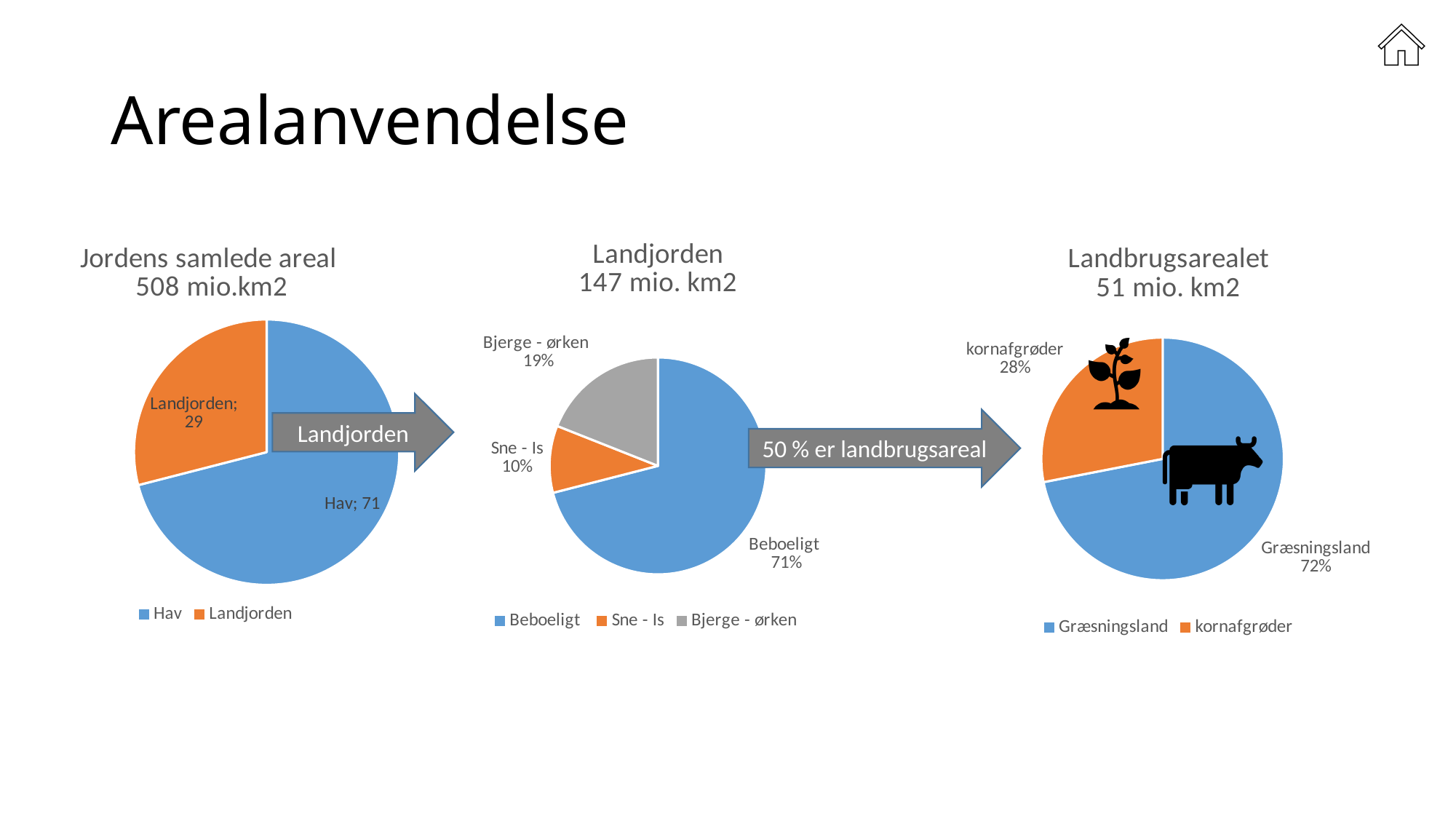
In the chart titled 'Jordens samlede areal 508 mio.km2', what is the value for Landjorden? 29 In the chart titled 'Jordens samlede areal 508 mio.km2', what is the difference between the values for Hav and Landjorden? 42 What kind of chart is the chart titled 'Landbrugsarealet 51 mio. km2'? Pie chart In the chart titled 'Landjorden 147 mio. km2', what percentage is Sne - Is? 10% In the chart titled 'Landjorden 147 mio. km2', which category has the largest share? Beboeligt In the chart titled 'Landjorden 147 mio. km2', which category has the smallest share? Sne - Is In the chart titled 'Landjorden 147 mio. km2', what colour is the Bjerge - ørken slice? Grey In the chart titled 'Jordens samlede areal 508 mio.km2', what is the value for Hav? 71 In the chart titled 'Landbrugsarealet 51 mio. km2', what percentage is kornafgrøder? 28% In the chart titled 'Landjorden 147 mio. km2', what percentage is Beboeligt? 71% In the chart titled 'Landbrugsarealet 51 mio. km2', which is larger, Græsningsland or kornafgrøder? Græsningsland In the chart titled 'Landjorden 147 mio. km2', how many categories are shown? 3